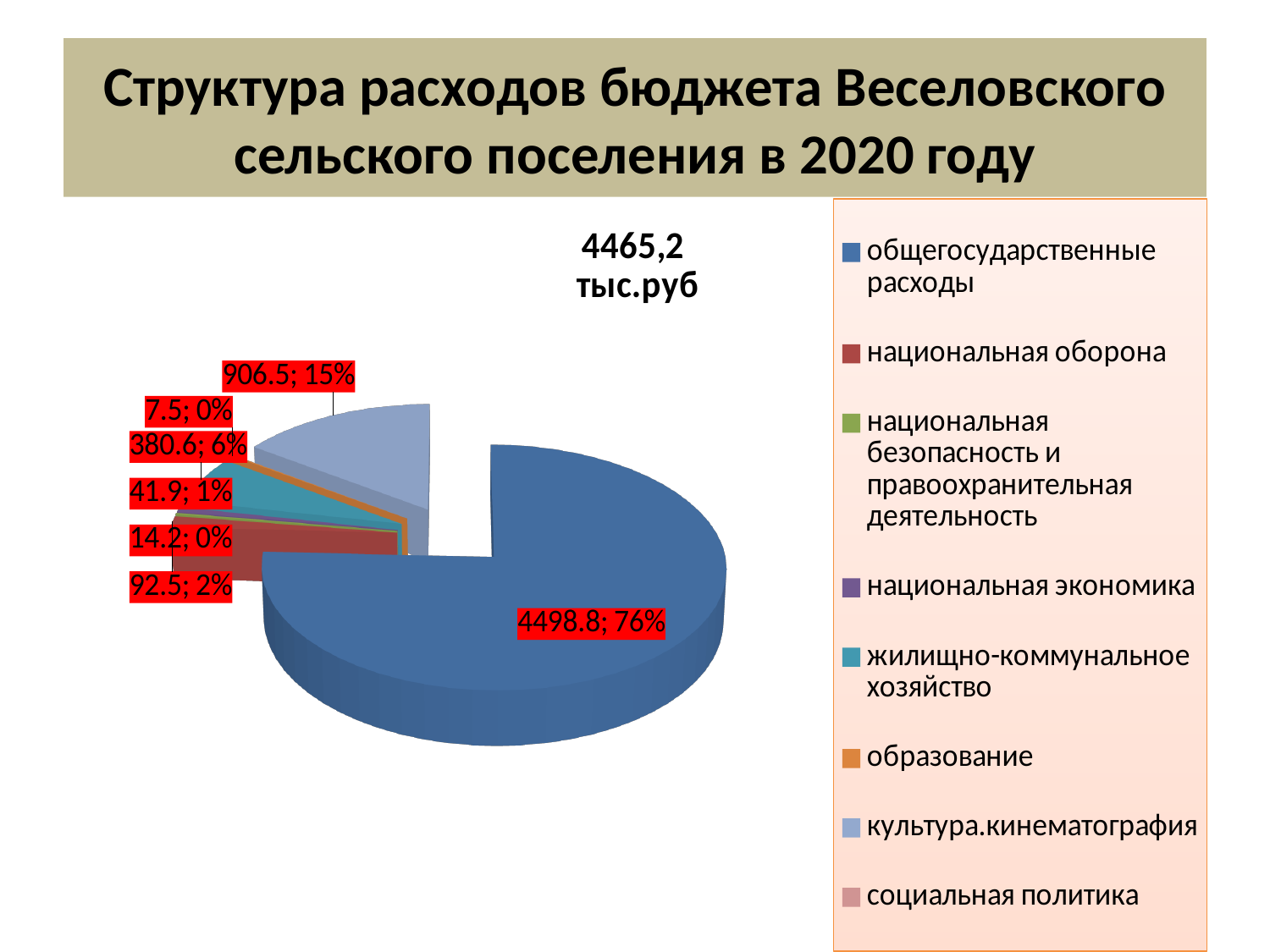
How many entries does the chart legend list? 8 What is the value shown for национальная оборона? 92.5 What is the value shown for культура.кинематография? 906.5 What share of the pie does общегосударственные расходы take? 76% What share of the pie does культура.кинематография take? 15% What kind of chart is shown on the slide? pie chart Which labelled category has the smallest value? образование What is the value shown for жилищно-коммунальное хозяйство? 380.6 Which category has the largest slice of the pie? общегосударственные расходы What is the difference between the values for культура.кинематография and жилищно-коммунальное хозяйство? 525.9 Which is larger, the value for национальная оборона or the value for национальная экономика? национальная оборона What is the value shown for общегосударственные расходы? 4498.8